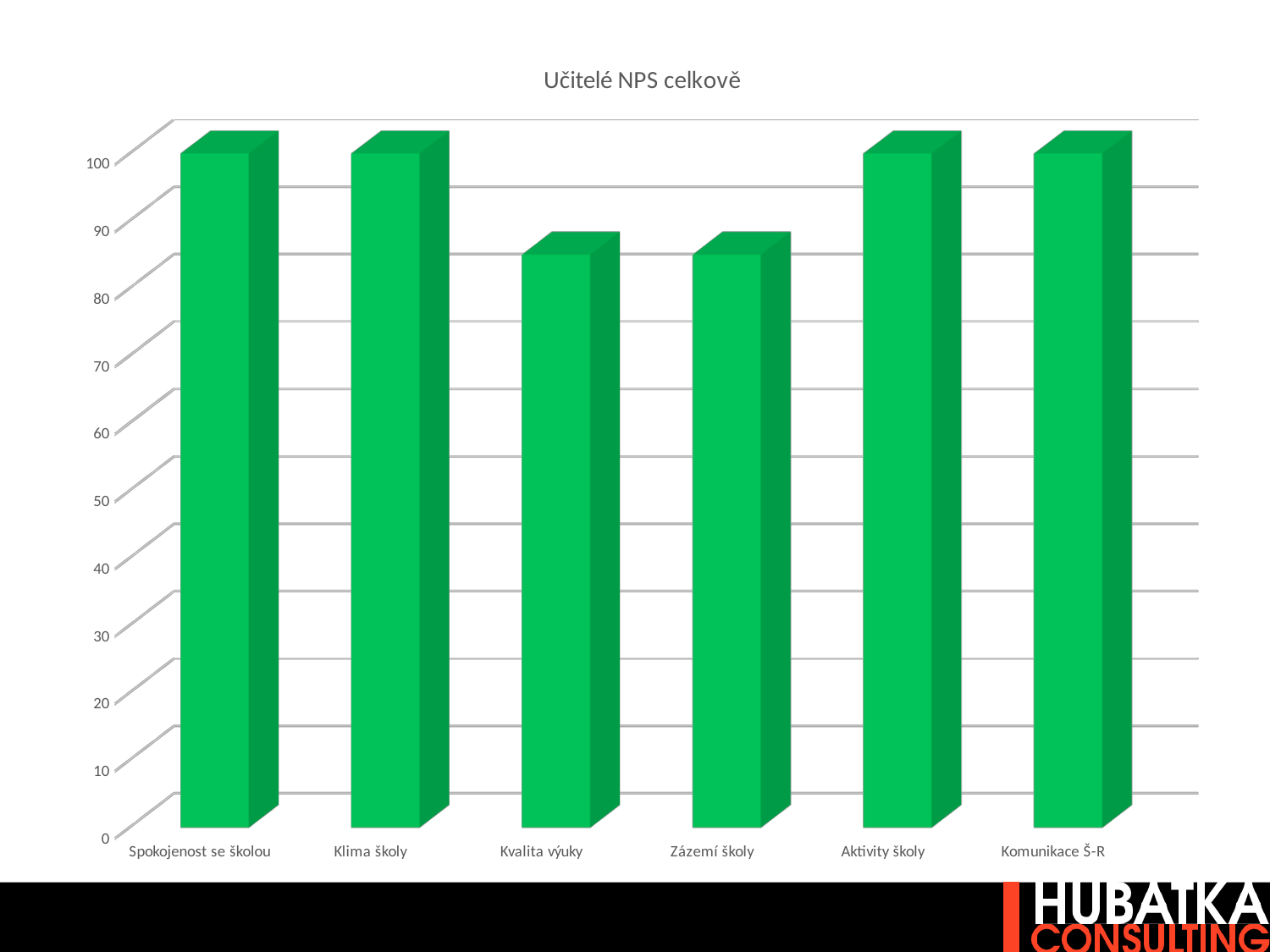
How many categories are shown on the x axis of the chart? 6 Is the value for Kvalita výuky greater or less than 90? less Is the value for Aktivity školy greater or less than 90? greater What colour are the bars in the chart? green Is the value for Zázemí školy greater or less than 80? greater What kind of chart is shown on the slide? bar chart Which is larger, the value for Zázemí školy or the value for Aktivity školy? Aktivity školy What is the title of the chart? Učitelé NPS celkově What is the label of the first category on the x axis? Spokojenost se školou Which is larger, the value for Klima školy or the value for Kvalita výuky? Klima školy